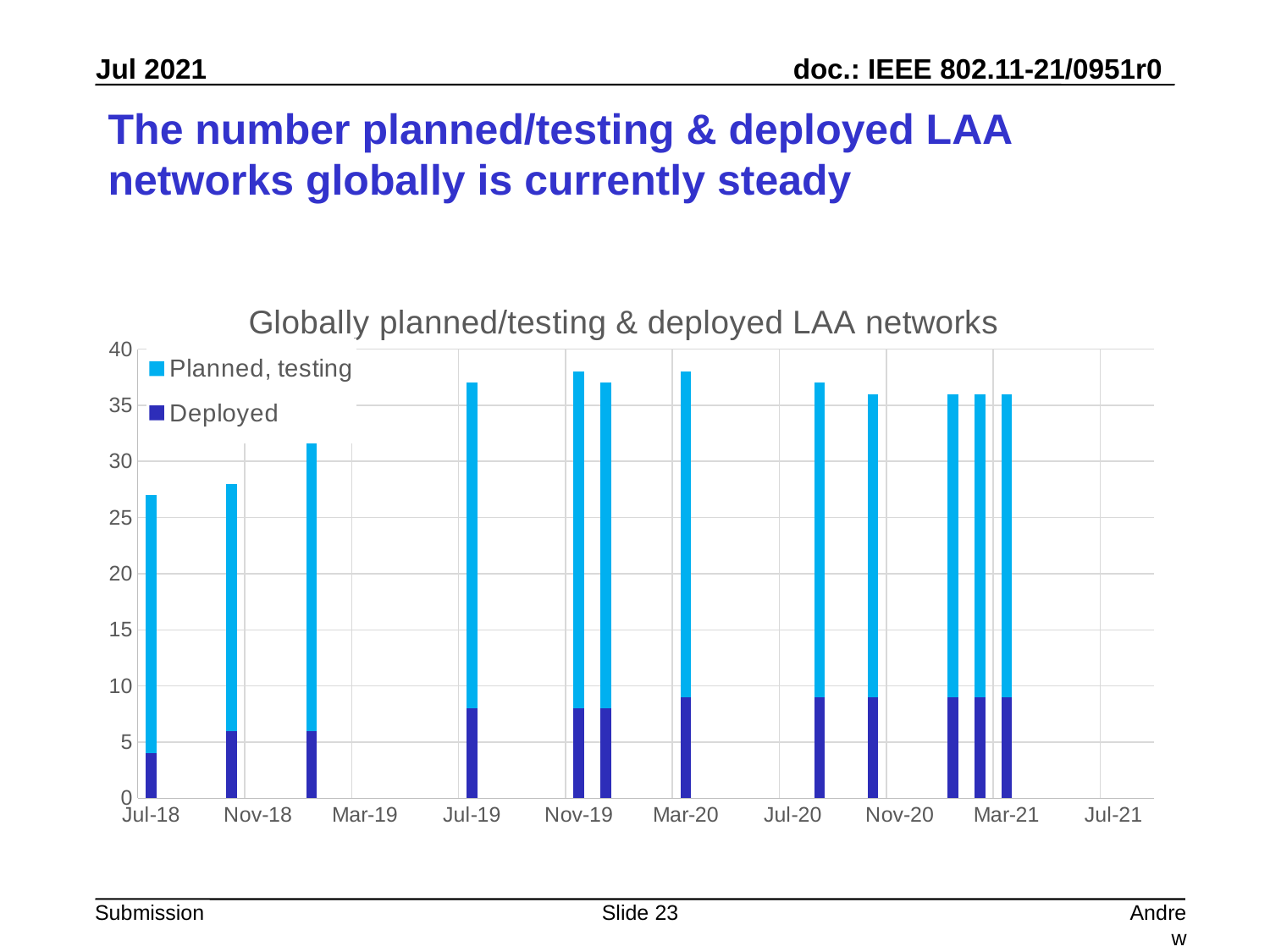
What kind of chart is shown on the slide? Stacked bar chart Is the total height of the bar at Jul-19 greater or less than 35? greater Do the total bar heights rise or fall from Jul-18 to Mar-20? rise Is the Deployed value at Jul-19 greater or less than 10? less What are the two series named in the chart legend? Planned, testing; Deployed Which bar is taller in total, Nov-18 or Mar-20? Mar-20 Is the total height of the bar at Jul-18 greater or less than 30? less Which bar is taller in total, Jul-18 or Jul-19? Jul-19 How many bars are plotted in the chart? 12 What is the title of the chart? Globally planned/testing & deployed LAA networks How many series does the chart legend list? 2